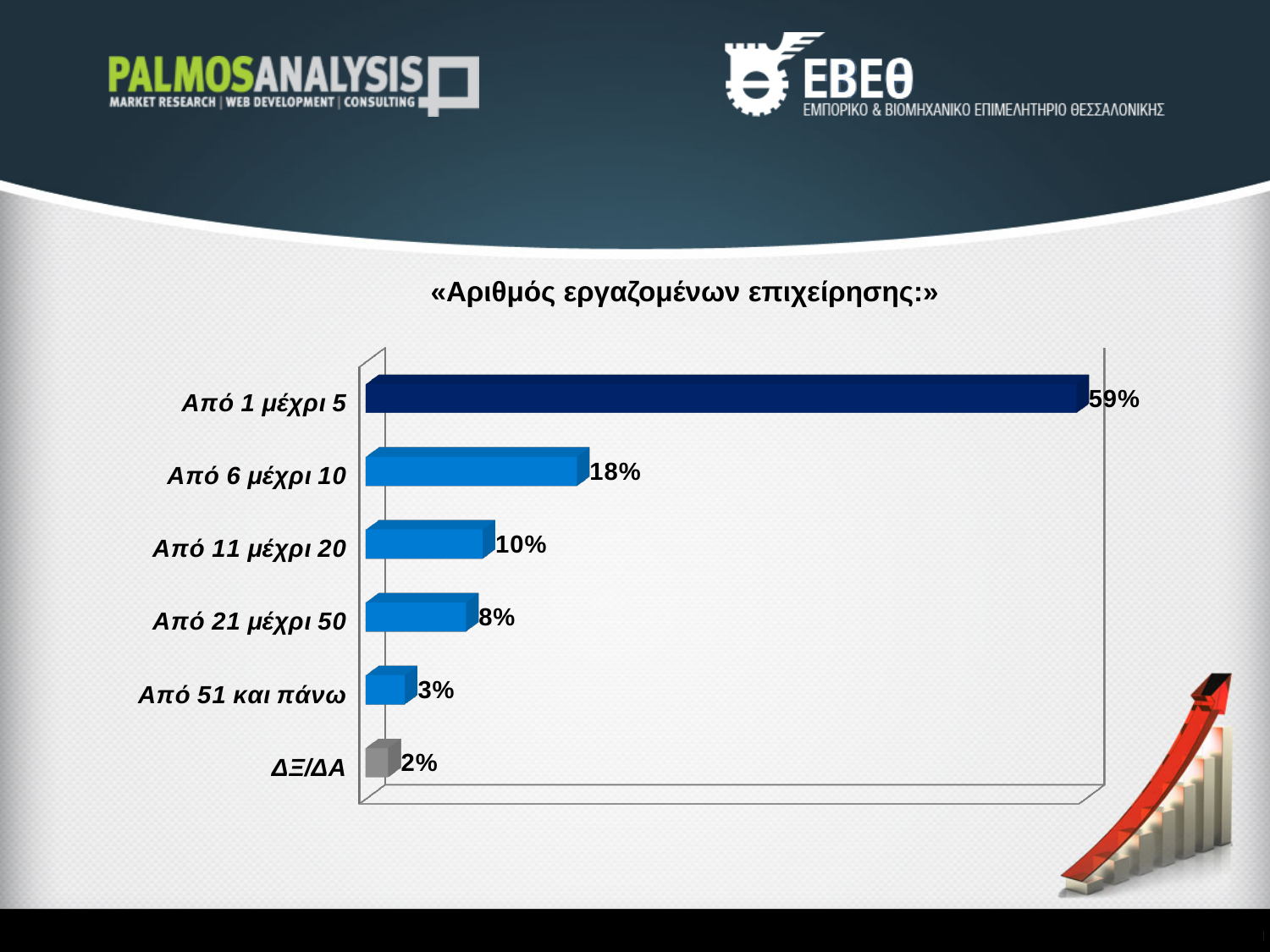
What is the value for "Από 11 μέχρι 20"? 10% Which category has the highest value? Από 1 μέχρι 5 What is the value for "Από 51 και πάνω"? 3% Which is larger, the value for "Από 21 μέχρι 50" or the value for "Από 51 και πάνω"? Από 21 μέχρι 50 What is the value for "ΔΞ/ΔΑ"? 2% What is the value for "Από 6 μέχρι 10"? 18% What kind of chart is shown on the slide? Bar chart What is the difference between the values for "Από 11 μέχρι 20" and "Από 21 μέχρι 50"? 2% Which category has the lowest value? ΔΞ/ΔΑ What is the value for "Από 1 μέχρι 5"? 59% How many categories are shown in the chart? 6 What is the difference between the values for "Από 1 μέχρι 5" and "Από 6 μέχρι 10"? 41%